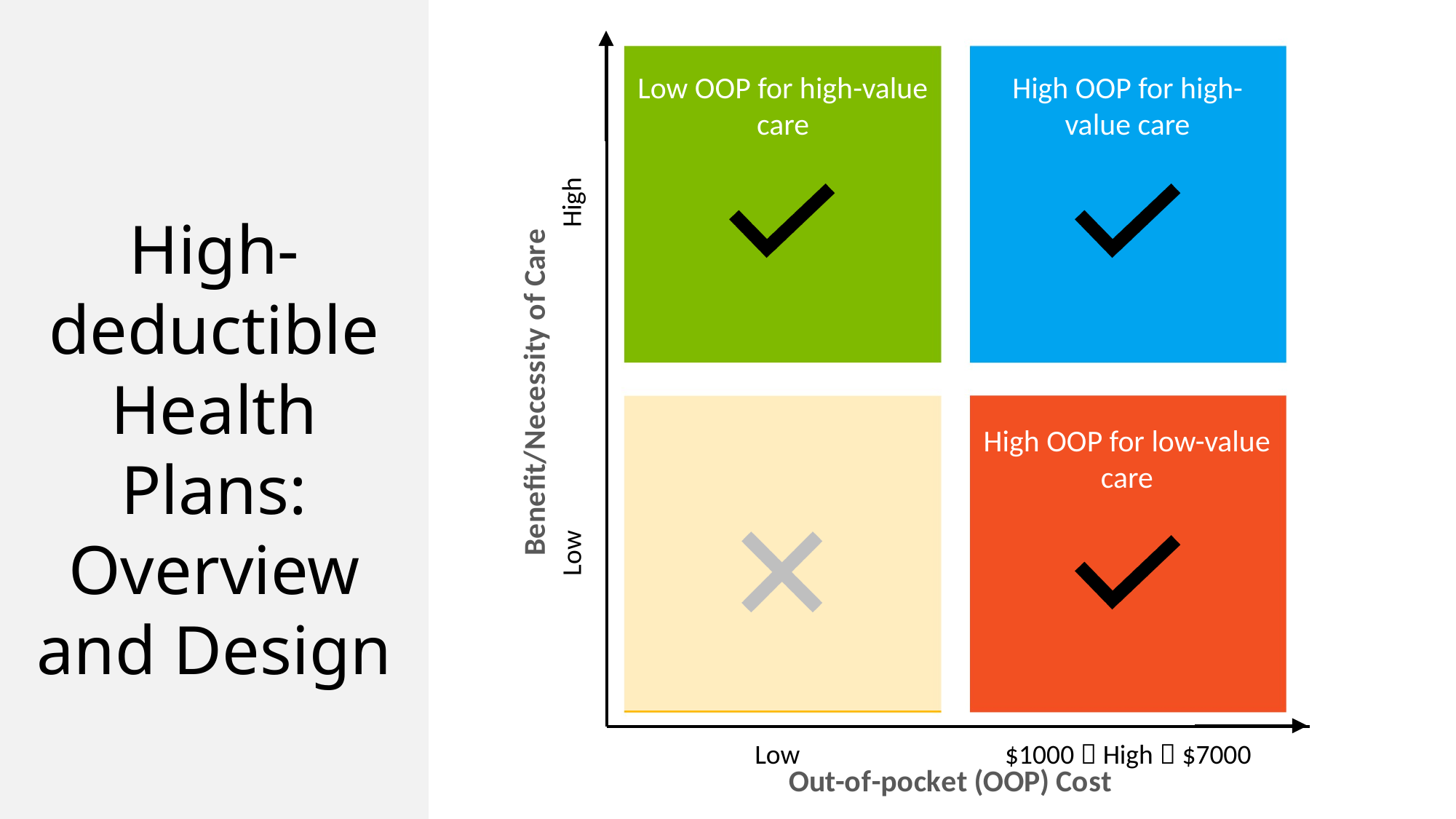
What text is written in the bottom-right (red) quadrant? High OOP for low-value care What is the label on the horizontal axis of the quadrant chart? Out-of-pocket (OOP) Cost Which quadrant has no text label? Bottom-left Which quadrant is marked with an X instead of a check mark? Bottom-left How many quadrants contain a check mark? 3 What are the two tick labels along the vertical axis, from bottom to top? Low, High How many quadrants does the chart show? 4 What text is written in the top-right (blue) quadrant? High OOP for high-value care What is the label on the vertical axis of the quadrant chart? Benefit/Necessity of Care What text is written in the top-left (green) quadrant? Low OOP for high-value care